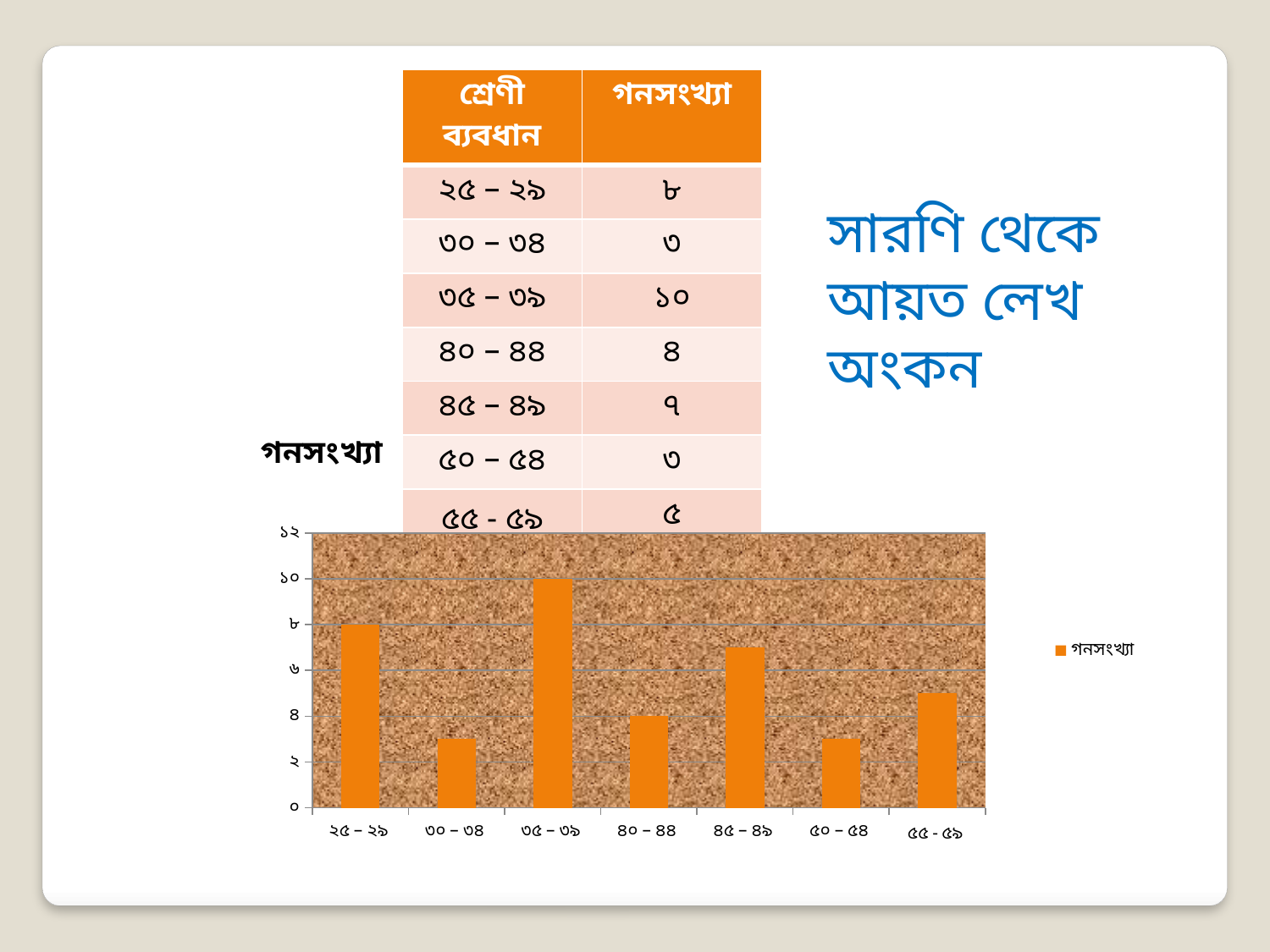
What is the value (গনসংখ্যা) for the class interval ৩৫ – ৩৯? ১০ How many class intervals (categories) are plotted on the x axis of the chart? 7 What is the value (গনসংখ্যা) for the class interval ২৫ – ২৯? ৮ Which class interval has the highest bar in the chart? ৩৫ – ৩৯ How many series does the chart legend list? 1 What is the difference between the values for ৩৫ – ৩৯ and ২৫ – ২৯? ২ What type of chart is shown on the slide? bar chart What is the value (গনসংখ্যা) for the class interval ৪০ – ৪৪? ৪ Is the bar for ৪৫ – ৪৯ greater or less than ৬? greater What is the legend entry shown for the chart's series? গনসংখ্যা Which has the larger value, ২৫ – ২৯ or ৪০ – ৪৪? ২৫ – ২৯ Is the bar for ৩০ – ৩৪ greater or less than ৪? less